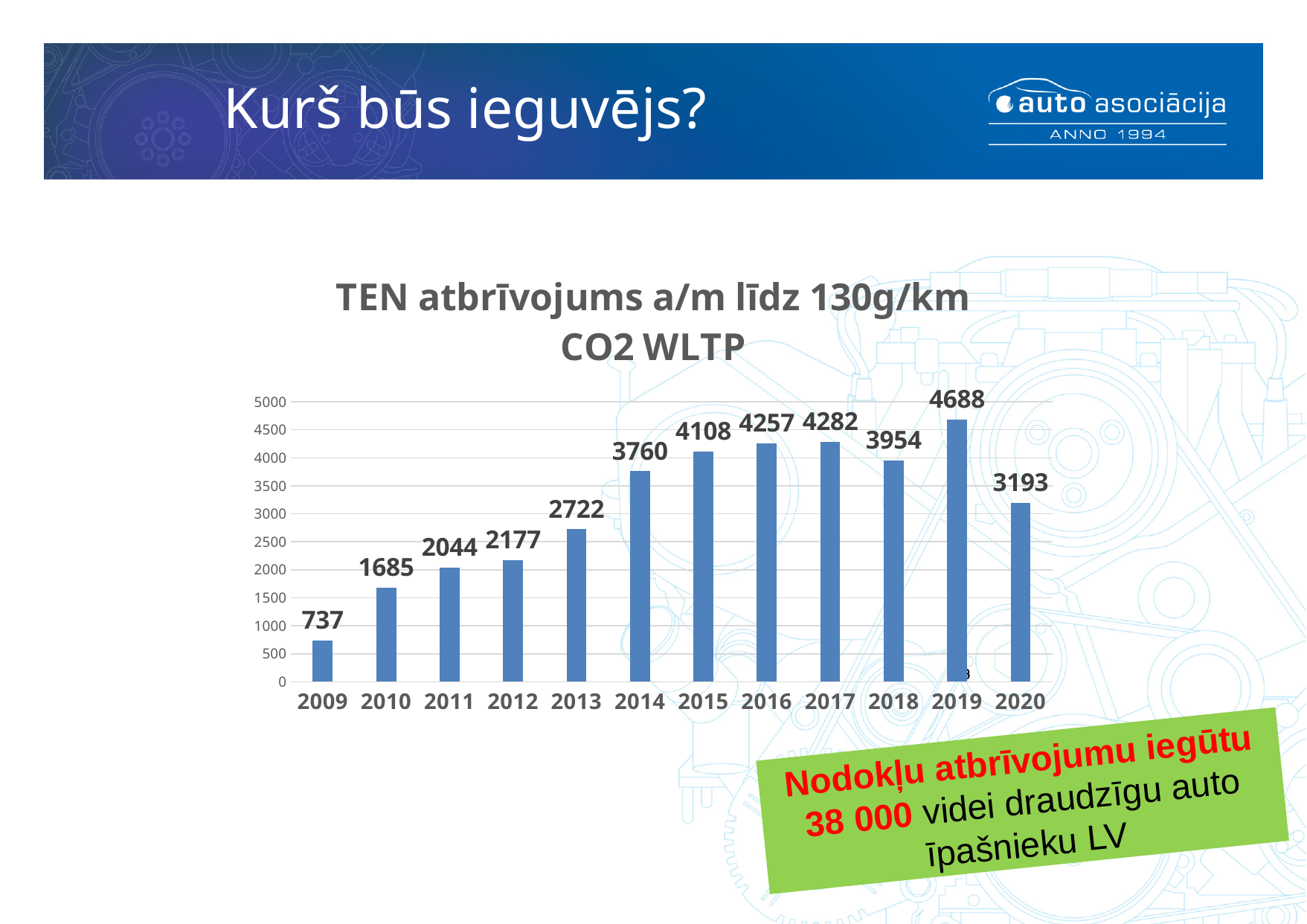
What is the value for 2020? 3193 What is the difference between the values for 2010 and 2009? 948 Which year has the lowest value? 2009 What kind of chart is this? bar chart How many years are shown on the x axis? 12 What is the value for 2014? 3760 What is the difference between the values for 2019 and 2020? 1495 What is the title of the chart? TEN atbrīvojums a/m līdz 130g/km CO2 WLTP Which is larger, the value for 2018 or the value for 2017? 2017 Is the value for 2013 greater or less than 3000? less Which year has the highest value? 2019 What is the value for 2009? 737